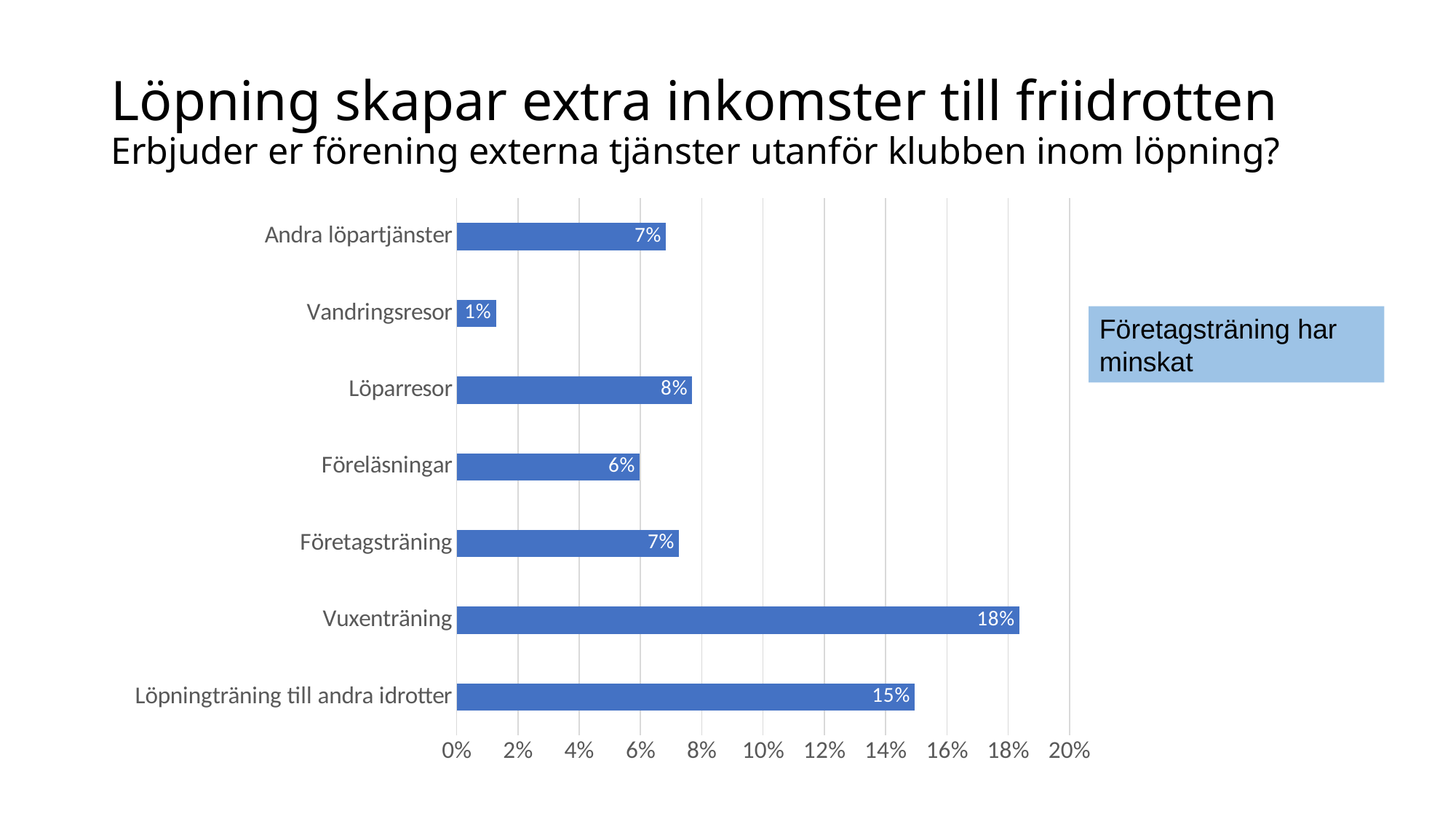
Which is larger, the value for Löparresor or the value for Föreläsningar? Löparresor What does the text box to the right of the chart say? Företagsträning har minskat What is the difference between the values for Vuxenträning and Löpningträning till andra idrotter? 3% What is the value for Föreläsningar? 6% What is the value for Vuxenträning? 18% What is the value for Löpningträning till andra idrotter? 15% What kind of chart is shown on the slide? Bar chart What is the value for Löparresor? 8% Which category has the highest value? Vuxenträning How many categories are shown in the chart? 7 Which category has the lowest value? Vandringsresor What is the value for Vandringsresor? 1%